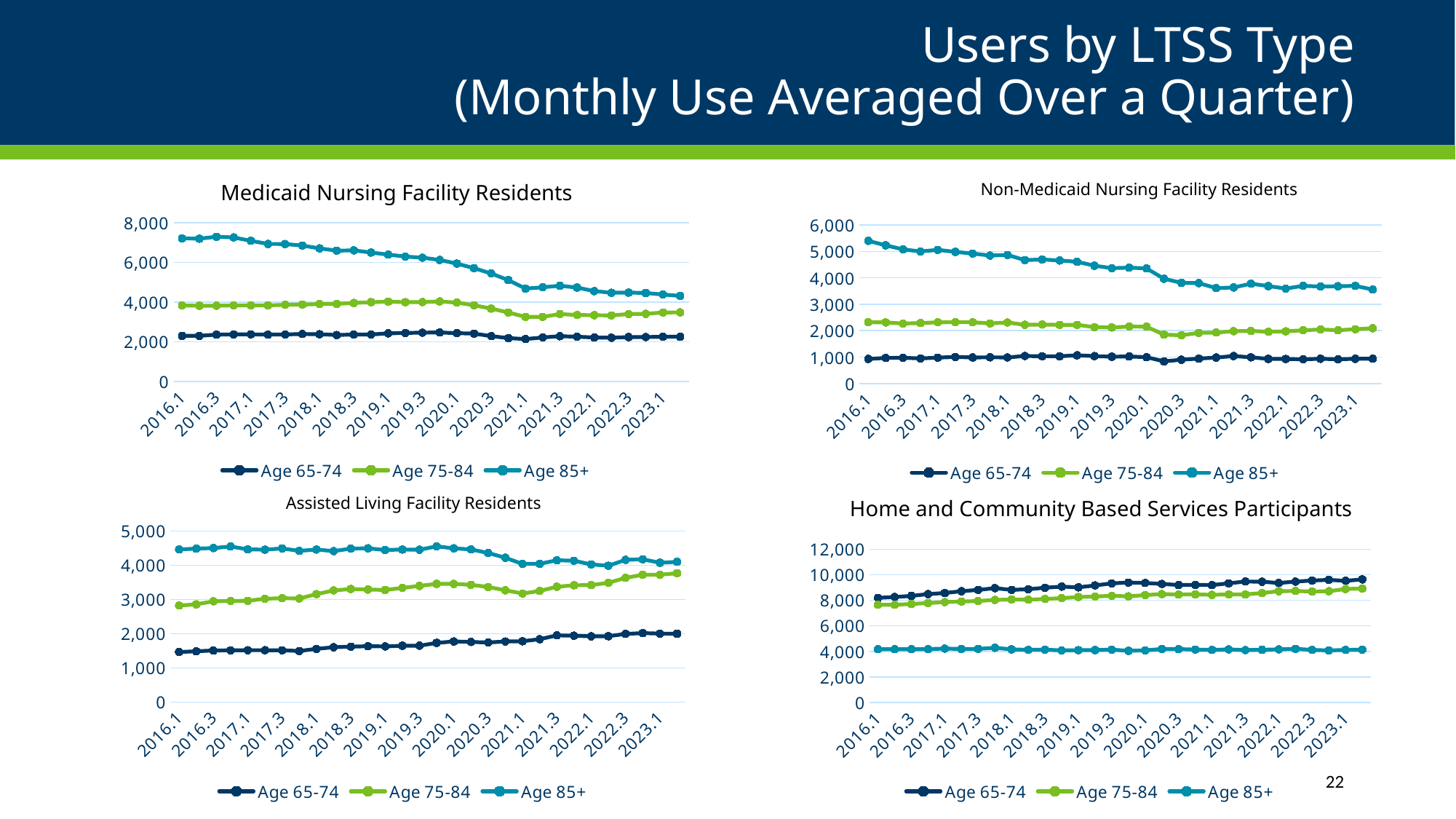
In the Medicaid Nursing Facility Residents chart, does the Age 85+ series rise or fall from 2016.1 to 2023.1? Fall In the Non-Medicaid Nursing Facility Residents chart, is the Age 65-74 value at 2023.1 greater or less than 2,000? less What kind of chart is the Medicaid Nursing Facility Residents chart? Line chart In the Medicaid Nursing Facility Residents chart, is the Age 85+ value at 2016.1 greater or less than 6,000? greater In the Medicaid Nursing Facility Residents chart, which is larger at 2023.1: Age 75-84 or Age 65-74? Age 75-84 How many series does the legend of the Home and Community Based Services Participants chart list? 3 In the Home and Community Based Services Participants chart, which age series has the lowest values? Age 85+ What are the three legend entries in the Assisted Living Facility Residents chart? Age 65-74, Age 75-84, Age 85+ In the Non-Medicaid Nursing Facility Residents chart, which age series has the highest values? Age 85+ In the Home and Community Based Services Participants chart, is the Age 85+ value at 2023.1 greater or less than 6,000? less In the Assisted Living Facility Residents chart, does the Age 75-84 series rise or fall from 2016.1 to 2023.1? Rise